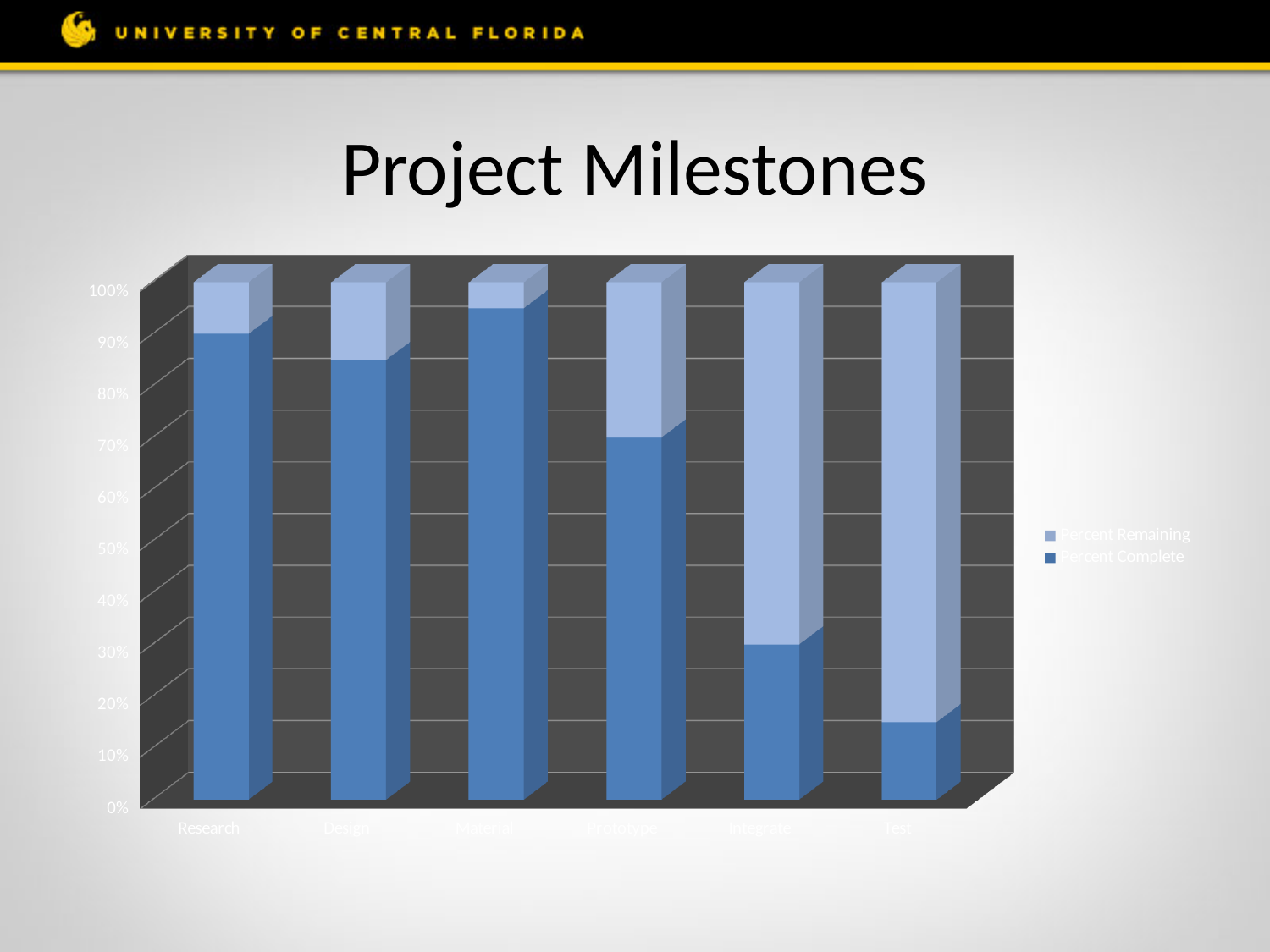
Which series is shown in the darker blue colour? Percent Complete Is the Percent Complete for Test greater or less than 20%? less What kind of chart is shown on the slide? Stacked bar chart How many milestone categories are shown on the x axis? 6 Is the Percent Complete for Prototype greater or less than 60%? greater Which milestone has the lowest Percent Complete? Test Is the Percent Complete for Integrate greater or less than 50%? less How many series does the legend list? 2 Which milestone has the largest Percent Remaining? Test What is the title of the chart? Project Milestones Which has a higher Percent Complete, Prototype or Integrate? Prototype